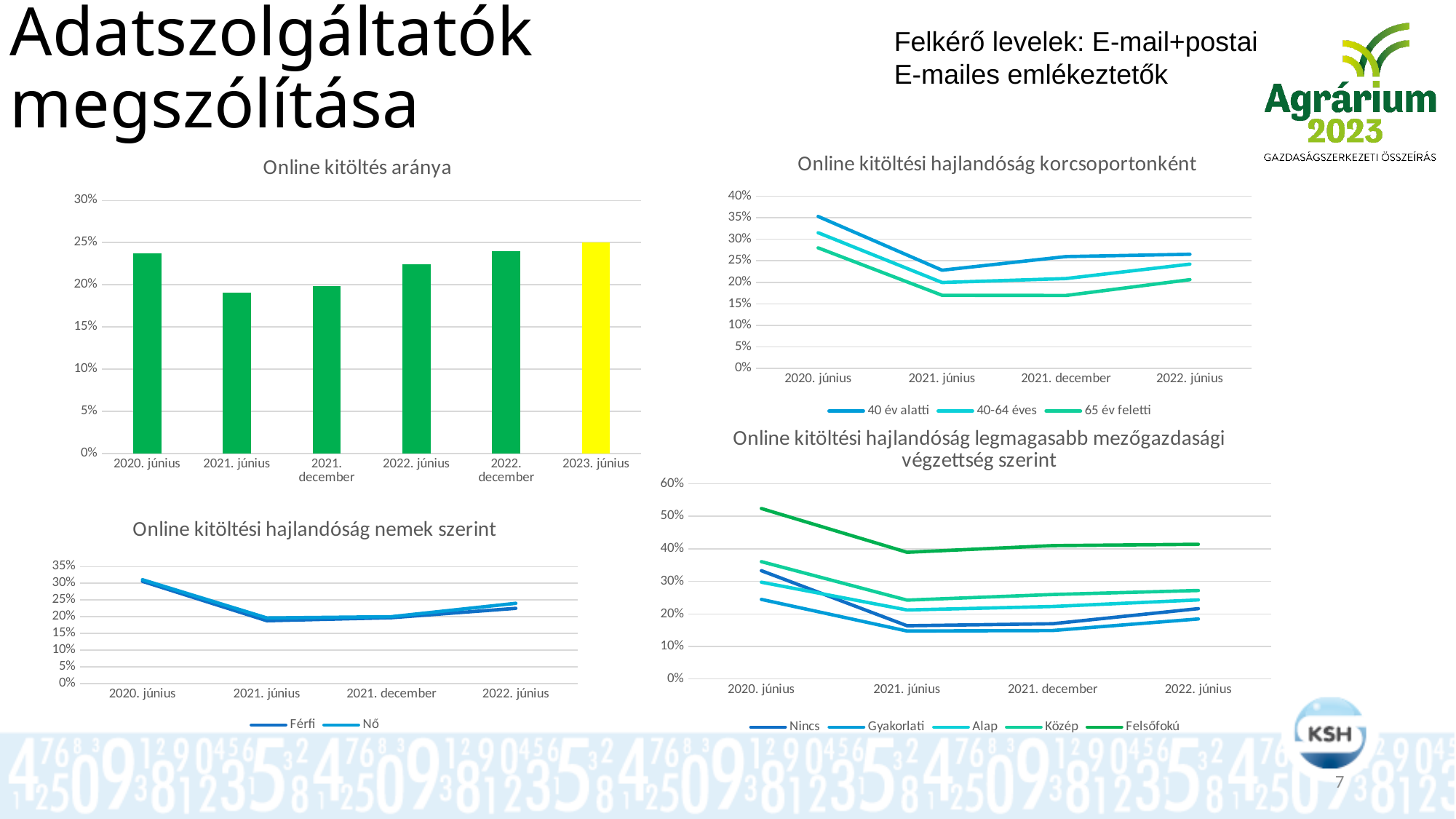
What kind of chart is "Online kitöltési hajlandóság nemek szerint"? line chart In the "Online kitöltés aránya" chart, is the value for 2020. június greater or less than 20%? greater How many categories are shown on the x axis of the "Online kitöltés aránya" chart? 6 In the "Online kitöltés aránya" chart, which category has the highest bar? 2023. június In the "Online kitöltési hajlandóság korcsoportonként" chart, is the value for 65 év feletti at 2021. június greater or less than 20%? less How many series does the legend of the "Online kitöltési hajlandóság legmagasabb mezőgazdasági végzettség szerint" chart list? 5 What kind of chart is "Online kitöltés aránya"? bar chart In the "Online kitöltési hajlandóság legmagasabb mezőgazdasági végzettség szerint" chart, is the value for Felsőfokú at 2020. június greater or less than 50%? greater How many series does the legend of the "Online kitöltési hajlandóság korcsoportonként" chart list? 3 In the "Online kitöltés aránya" chart, which bar is drawn in a different colour (yellow) from the others? 2023. június In the "Online kitöltési hajlandóság korcsoportonként" chart, which series has the highest value at 2020. június? 40 év alatti